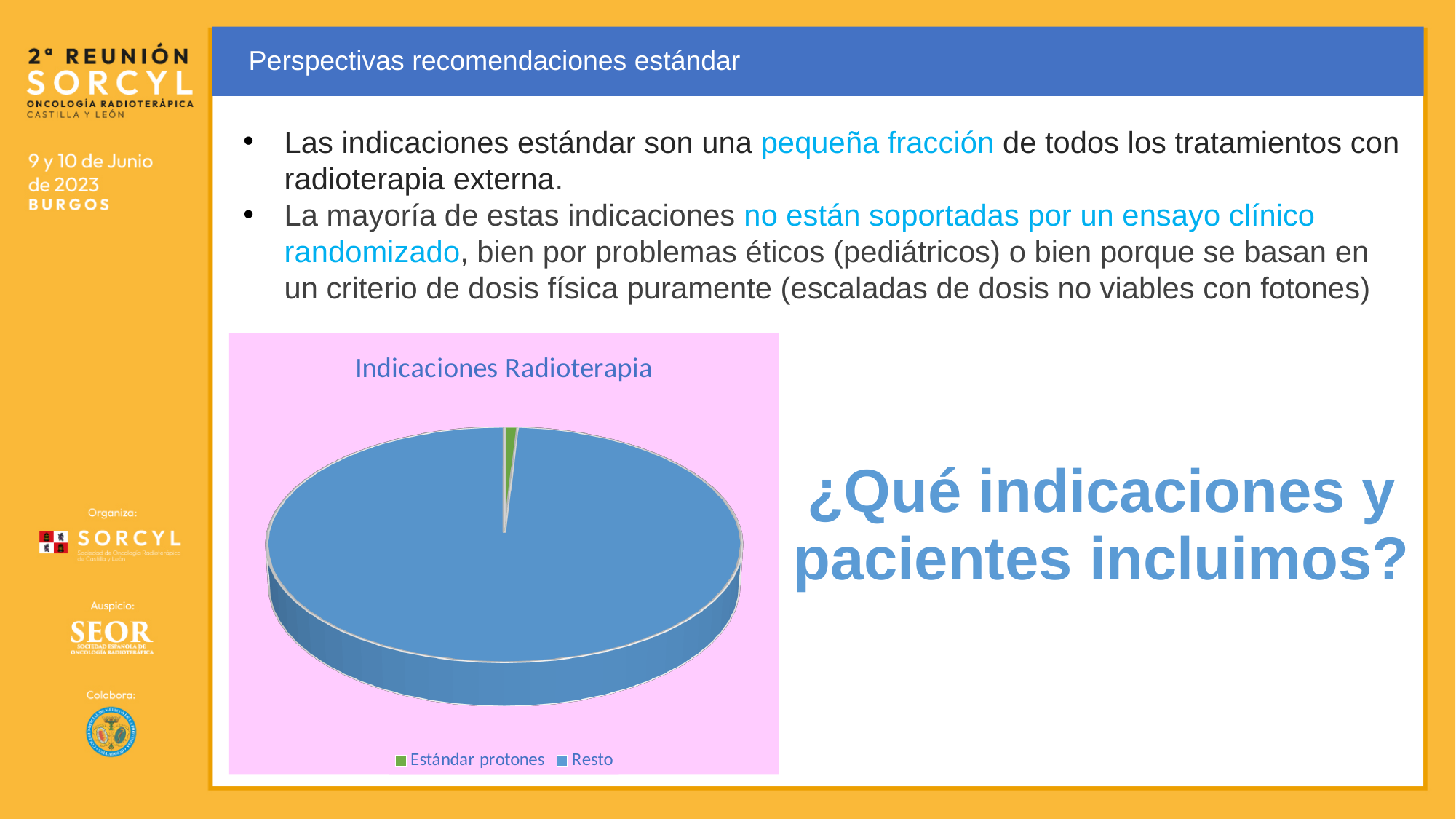
What are the two categories listed in the legend of the pie chart? Estándar protones and Resto Which category has the largest slice of the pie chart? Resto What kind of chart is shown on the slide? Pie chart What is the title of the chart? Indicaciones Radioterapia Which slice is larger, Estándar protones or Resto? Resto How many categories does the legend of the pie chart list? 2 Which category has the smallest slice of the pie chart? Estándar protones What colour is the slice for Estándar protones? Green